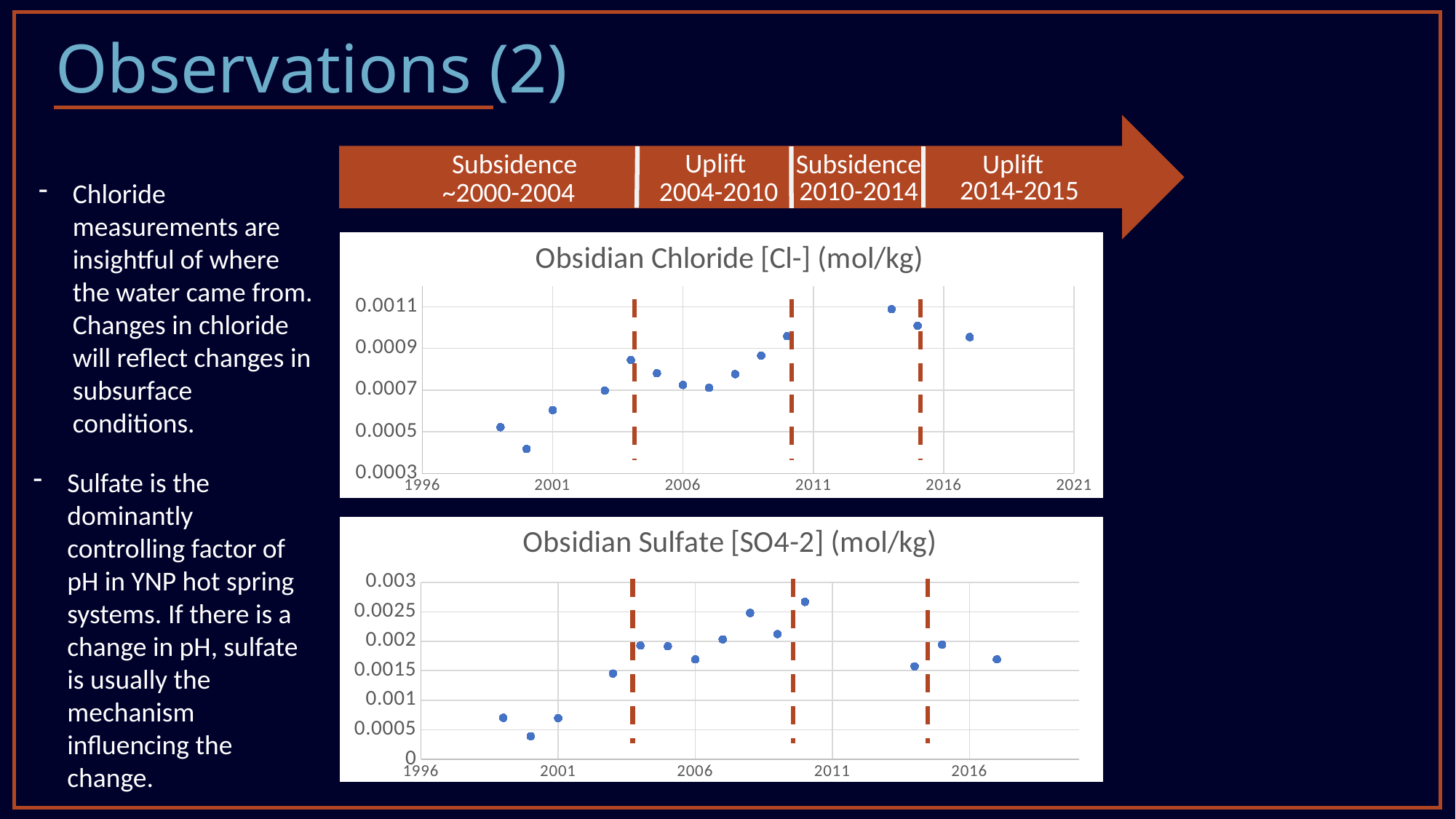
What kind of chart is the 'Obsidian Sulfate [SO4-2] (mol/kg)' chart? scatter chart In the 'Obsidian Sulfate [SO4-2] (mol/kg)' chart, do sulfate values generally rise or fall between 1999 and 2010? rise In the 'Obsidian Chloride [Cl-] (mol/kg)' chart, is the value of the point near 2014 greater or less than 0.0009? greater In the 'Obsidian Chloride [Cl-] (mol/kg)' chart, do chloride values generally rise or fall between 1999 and 2014? rise In the 'Obsidian Chloride [Cl-] (mol/kg)' chart, around which year does the lowest chloride value occur? 2000 In the 'Obsidian Chloride [Cl-] (mol/kg)' chart, what is the highest value shown on the y axis? 0.0011 What kind of chart is the 'Obsidian Chloride [Cl-] (mol/kg)' chart? scatter chart What is the title of the top chart on the slide? Obsidian Chloride [Cl-] (mol/kg) In the 'Obsidian Chloride [Cl-] (mol/kg)' chart, is the value of the earliest point (around 1999) greater or less than 0.0007? less In the 'Obsidian Sulfate [SO4-2] (mol/kg)' chart, around which year does the highest sulfate value occur? 2010 In the 'Obsidian Sulfate [SO4-2] (mol/kg)' chart, is the value of the point near 2000 greater or less than 0.001? less